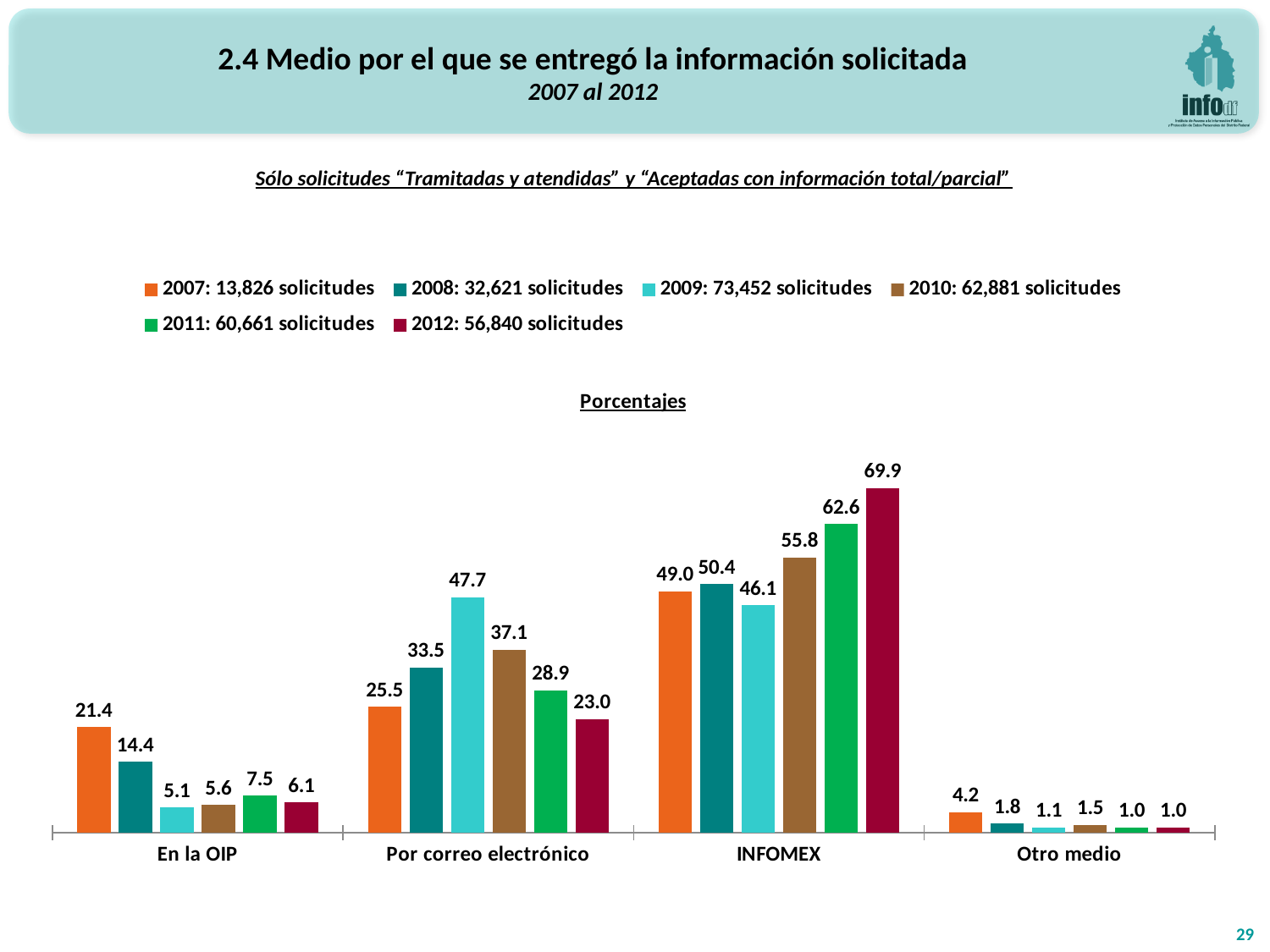
What kind of chart is shown on the slide? Bar chart Which year has the highest value in the INFOMEX category? 2012 Which is larger in the "Por correo electrónico" category: the value for 2010 or the value for 2011? 2010 Which year has the lowest value in the "En la OIP" category? 2009 How many categories are shown on the x axis? 4 What is the value for 2007 in the "En la OIP" category? 21.4 What is the value for 2012 in the INFOMEX category? 69.9 Do the values in the INFOMEX category rise or fall from 2010 to 2012? Rise According to the legend, how many solicitudes were there in 2009? 73,452 What is the difference between the 2012 and 2007 values in the INFOMEX category? 20.9 How many series does the legend list? 6 What is the value for 2009 in the "Por correo electrónico" category? 47.7